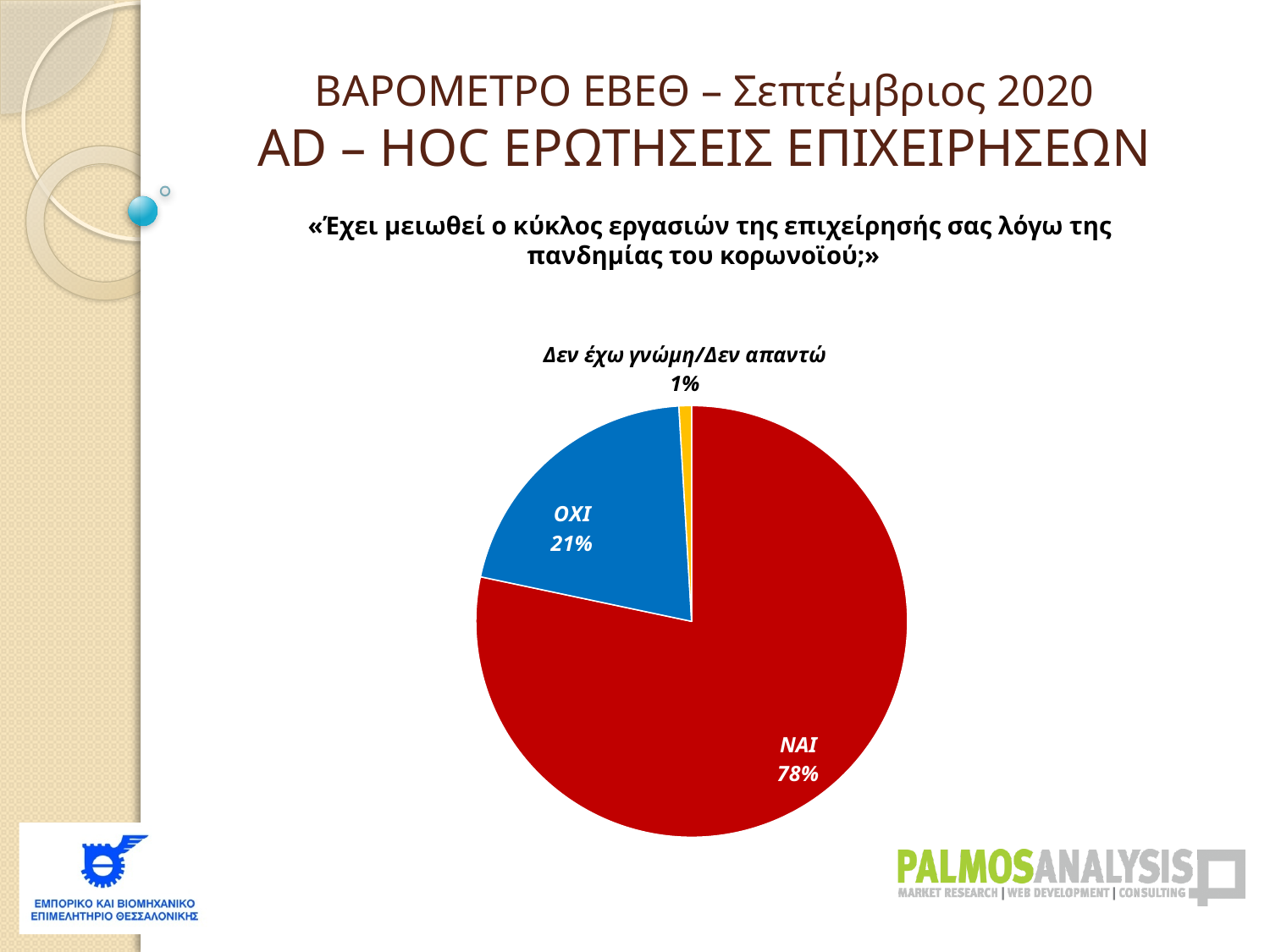
What colour is the ΝΑΙ slice? red What colour is the ΟΧΙ slice? blue What percentage of respondents answered ΝΑΙ? 78% How many slices does the pie chart have? 3 Which response has the smallest share of the pie? Δεν έχω γνώμη/Δεν απαντώ What percentage of respondents answered Δεν έχω γνώμη/Δεν απαντώ? 1% Which response has the largest share of the pie? ΝΑΙ What kind of chart is shown on the slide? pie chart What is the difference in percentage points between the ΝΑΙ and ΟΧΙ shares? 57 Which is larger, the share for ΟΧΙ or the share for Δεν έχω γνώμη/Δεν απαντώ? ΟΧΙ What percentage of respondents answered ΟΧΙ? 21% What is the combined share of ΟΧΙ and Δεν έχω γνώμη/Δεν απαντώ? 22%